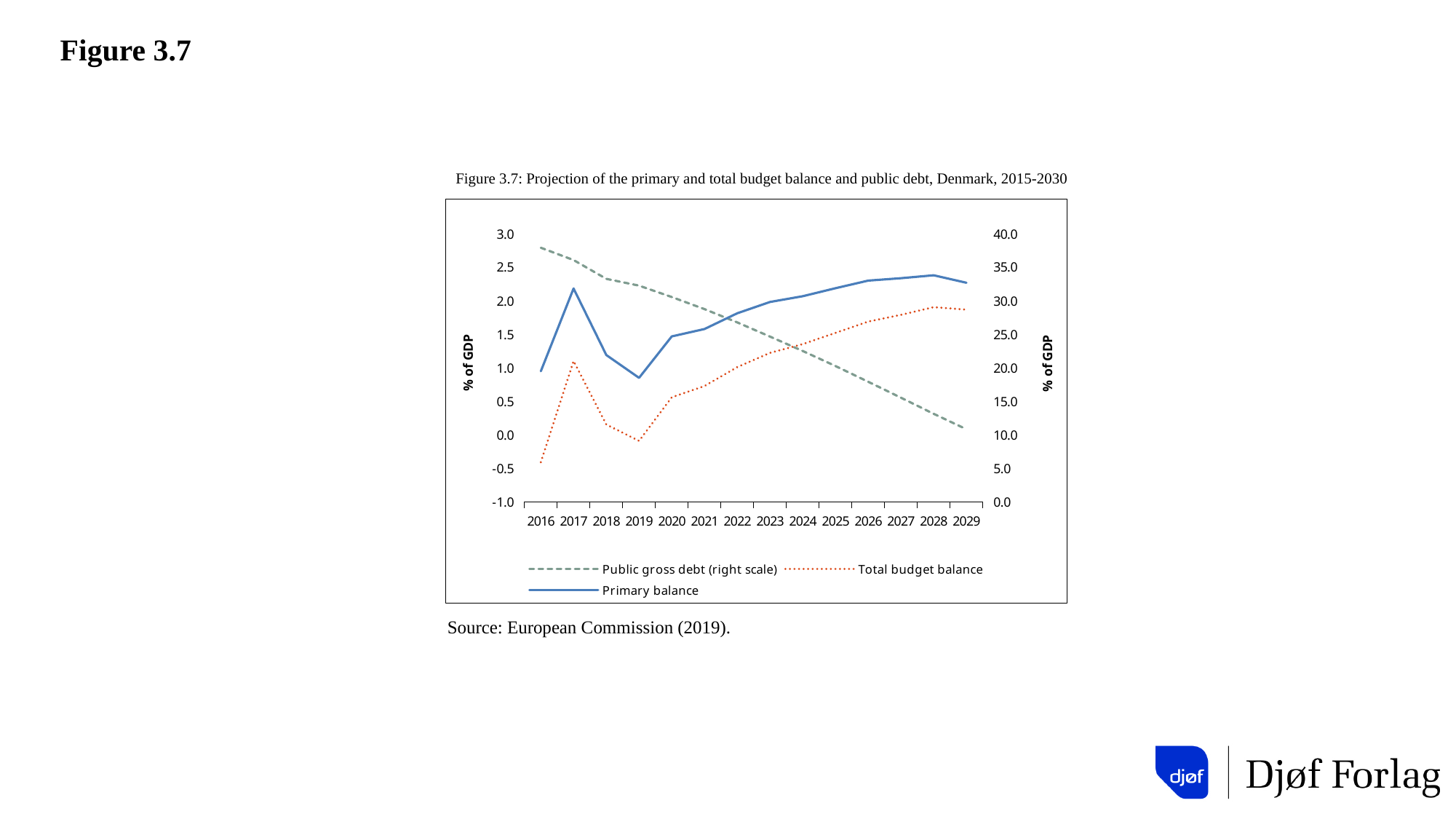
How many years are shown on the x axis? 14 In which year is Public gross debt highest? 2016 Is the Primary balance in 2017 greater or less than 2.0? greater What is the label of the left vertical axis? % of GDP What kind of chart is shown on the slide? Line chart Is the Public gross debt in 2016 greater or less than 35.0? greater Does the Public gross debt series rise or fall from 2016 to 2029? Fall Which is larger in 2020, the Primary balance or the Total budget balance? Primary balance In which year is the Total budget balance lowest? 2016 Does the Total budget balance series generally rise or fall from 2019 to 2028? Rise How many series does the legend list? 3 In which year is Public gross debt lowest? 2029